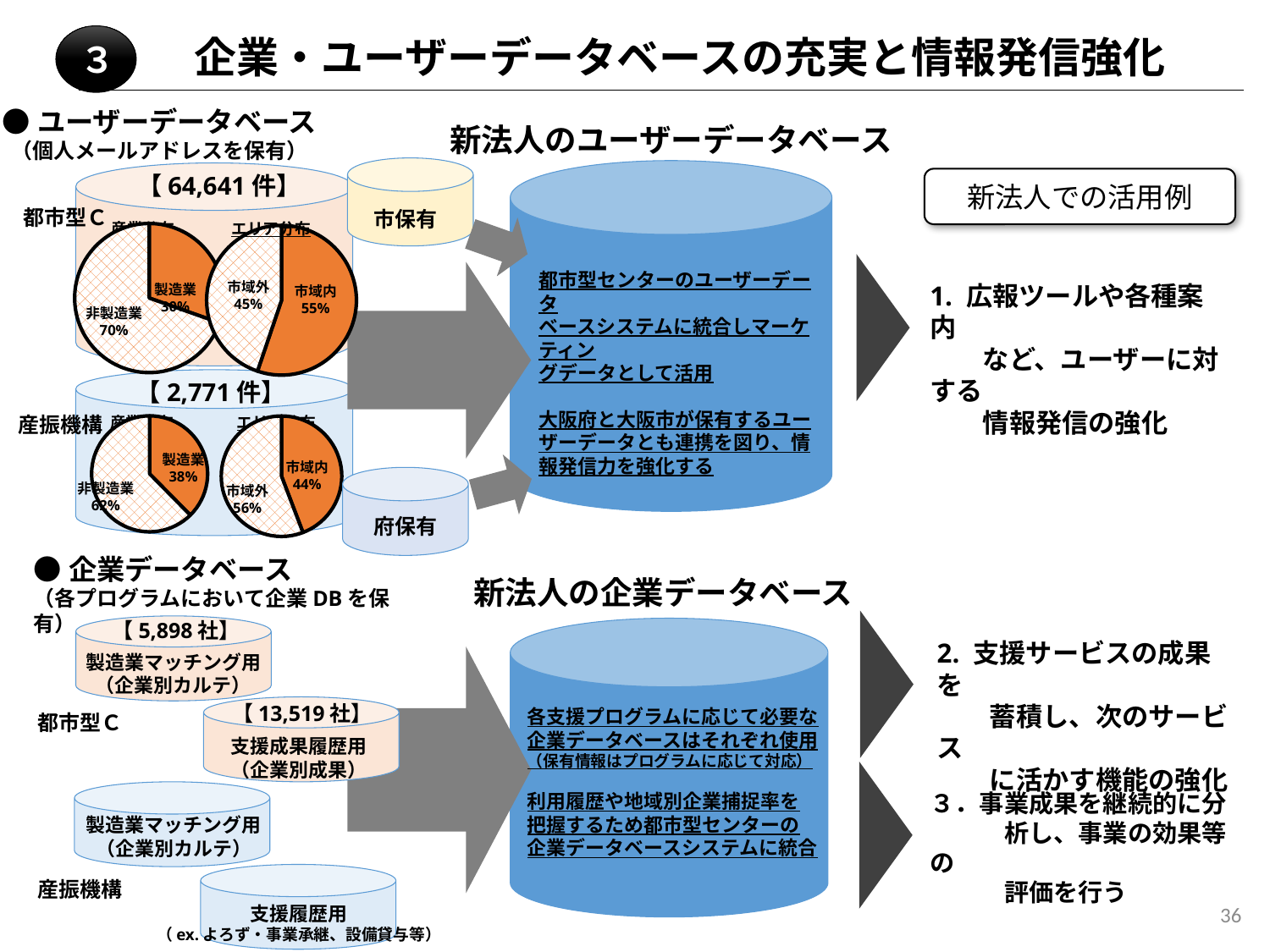
In the 都市型C pie chart showing 製造業 and 非製造業, which slice is larger? 非製造業 In the 都市型C エリア分布 pie chart, what share is 市域内? 55% How many slices does the 都市型C エリア分布 pie chart have? 2 In the 産振機構 pie chart showing 製造業 and 非製造業, what share is 製造業? 38% In the 都市型C pie chart showing 製造業 and 非製造業, what share is 非製造業? 70% In the 産振機構 pie chart showing 製造業 and 非製造業, what is the difference between the 非製造業 and 製造業 shares? 24% In the 都市型C エリア分布 pie chart, what share is 市域外? 45% What kind of chart is used to show the 業種 and エリア distributions on this slide? Pie chart In the 産振機構 pie chart showing 市域内 and 市域外, what share is 市域内? 44% In the 都市型C pie chart showing 製造業 and 非製造業, what share is 製造業? 30% In the 産振機構 pie chart showing 市域内 and 市域外, what share is 市域外? 56% In the 都市型C エリア分布 pie chart, what is the difference between the 市域内 and 市域外 shares? 10%